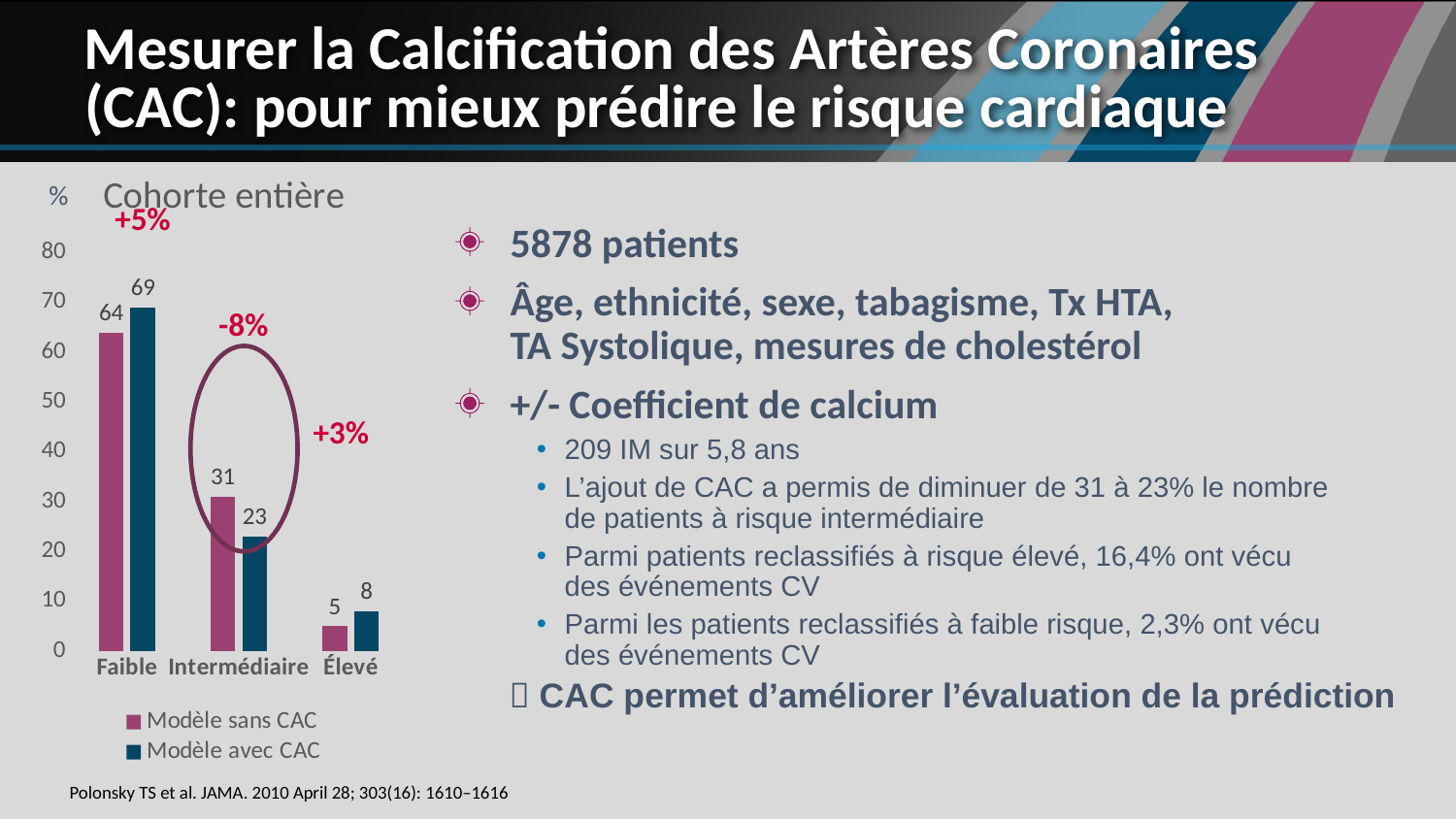
For Élevé, which series has the larger value, Modèle sans CAC or Modèle avec CAC? Modèle avec CAC Which category has the lowest value in the Modèle sans CAC series? Élevé What is the value for Faible in the Modèle sans CAC series? 64 What kind of chart is shown on the slide? bar chart Which category has the highest value in the Modèle avec CAC series? Faible What is the difference between the Modèle sans CAC and Modèle avec CAC values for Intermédiaire? 8 How many categories are shown on the x axis? 3 What is the value for Intermédiaire in the Modèle avec CAC series? 23 What is the value for Élevé in the Modèle sans CAC series? 5 What is the title of the chart? Cohorte entière Is the value for Faible in the Modèle avec CAC series greater or less than 60? greater How many series does the legend list? 2